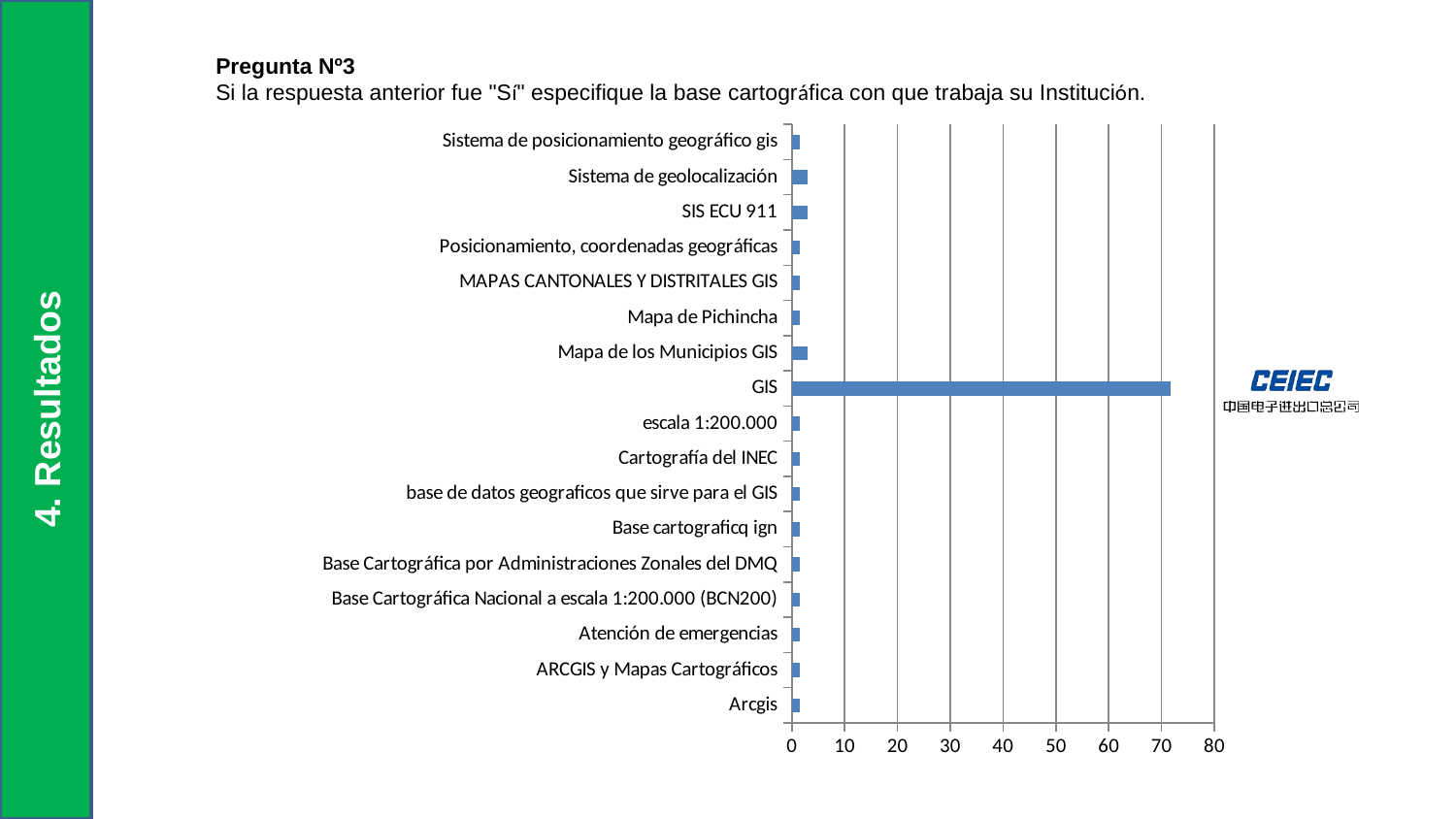
Is the value for GIS greater or less than 60? greater How many categories are plotted in the chart? 17 Is the value for SIS ECU 911 greater or less than 10? less What kind of chart is shown on the slide? bar chart Which question number does the chart on the slide refer to? Pregunta Nº3 Is the value for Arcgis greater or less than 10? less Which is larger, the value for GIS or the value for Sistema de geolocalización? GIS Which is larger, the value for GIS or the value for Cartografía del INEC? GIS Which category has the highest value in the chart? GIS What is the highest value shown on the horizontal axis of the chart? 80